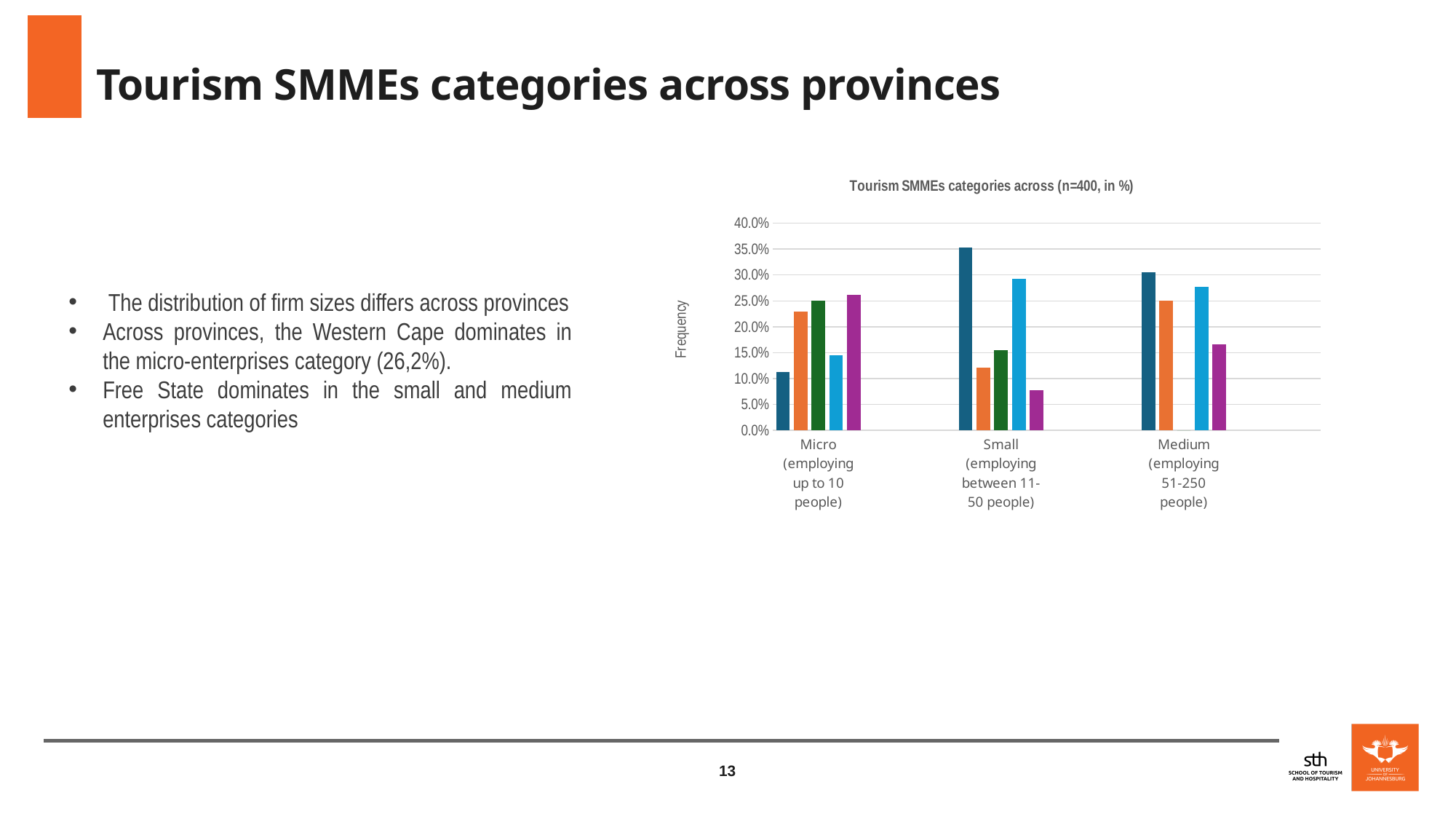
Is the value of the purple bar for Small (employing between 11-50 people) greater or less than 10.0%? less What is the label on the vertical axis of the chart? Frequency Which coloured bar is the tallest in the Small (employing between 11-50 people) group? Dark blue Is the value of the dark blue bar for Small (employing between 11-50 people) greater or less than 30.0%? greater Is the value of the dark blue bar for Micro (employing up to 10 people) greater or less than 15.0%? less What is the title of the chart? Tourism SMMEs categories across (n=400, in %) Which coloured bar is the shortest in the Micro (employing up to 10 people) group? Dark blue What kind of chart is shown on the slide? Bar chart How many bars are plotted in the Small (employing between 11-50 people) group? 5 Is the orange bar larger for Micro (employing up to 10 people) or for Small (employing between 11-50 people)? Micro (employing up to 10 people) How many enterprise size categories are shown on the x axis of the chart? 3